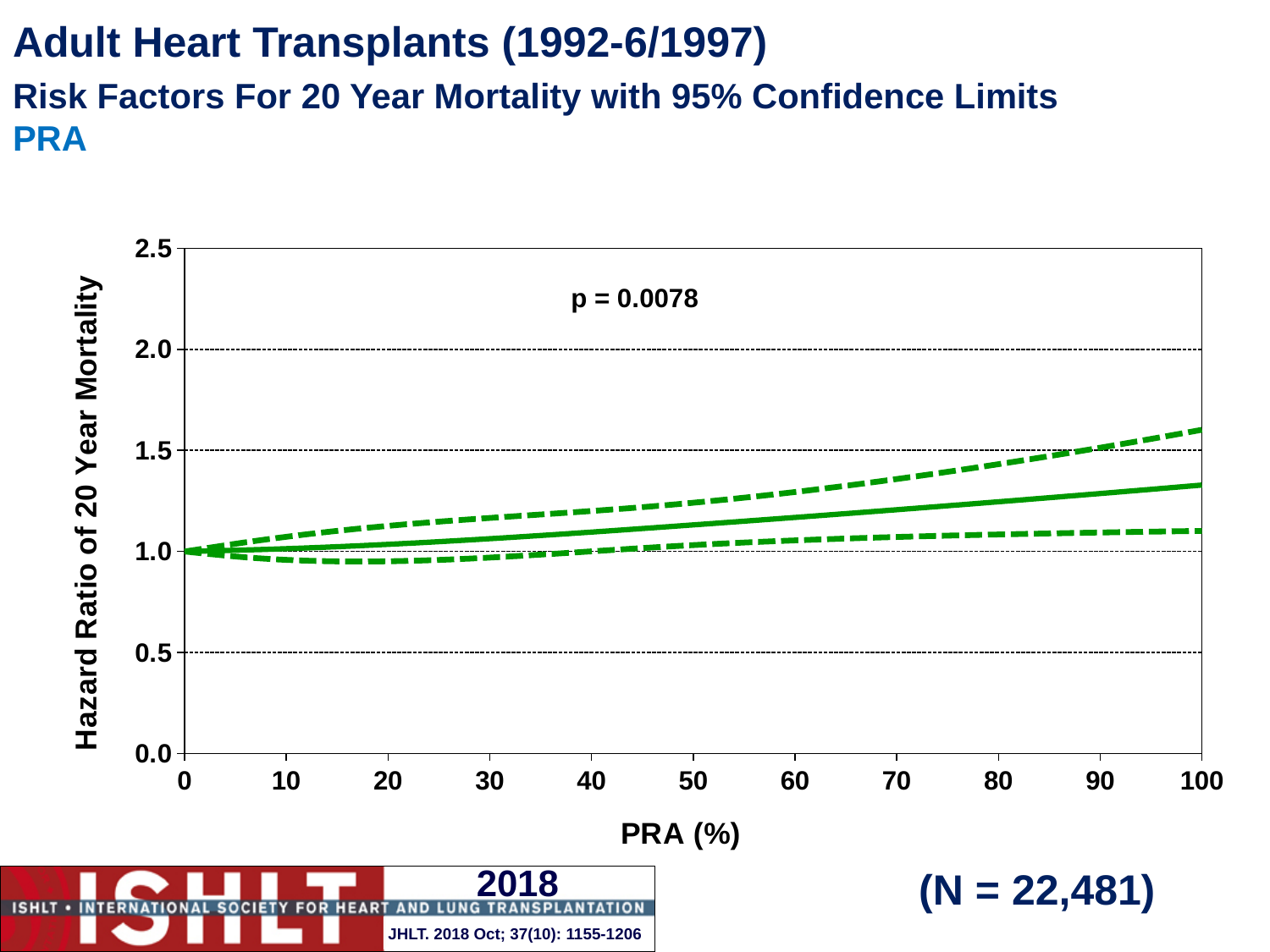
How many lines are plotted on the chart? 3 What is the sample size (N) shown on the slide? N = 22,481 Is the upper dashed confidence limit at PRA 100% greater or less than 2.0? less Is the hazard ratio of the solid line at PRA 100% greater or less than 1.5? less What kind of chart is shown on the slide? line chart Which is larger at PRA 100%: the upper dashed confidence limit or the solid hazard ratio line? the upper dashed confidence limit What is the p-value printed on the chart? p = 0.0078 Is the hazard ratio of the solid line at PRA 100% greater or less than 1.0? greater What is the hazard ratio of the solid line at PRA 0%? 1.0 Does the solid hazard ratio line rise or fall as PRA increases from 0 to 100%? rise